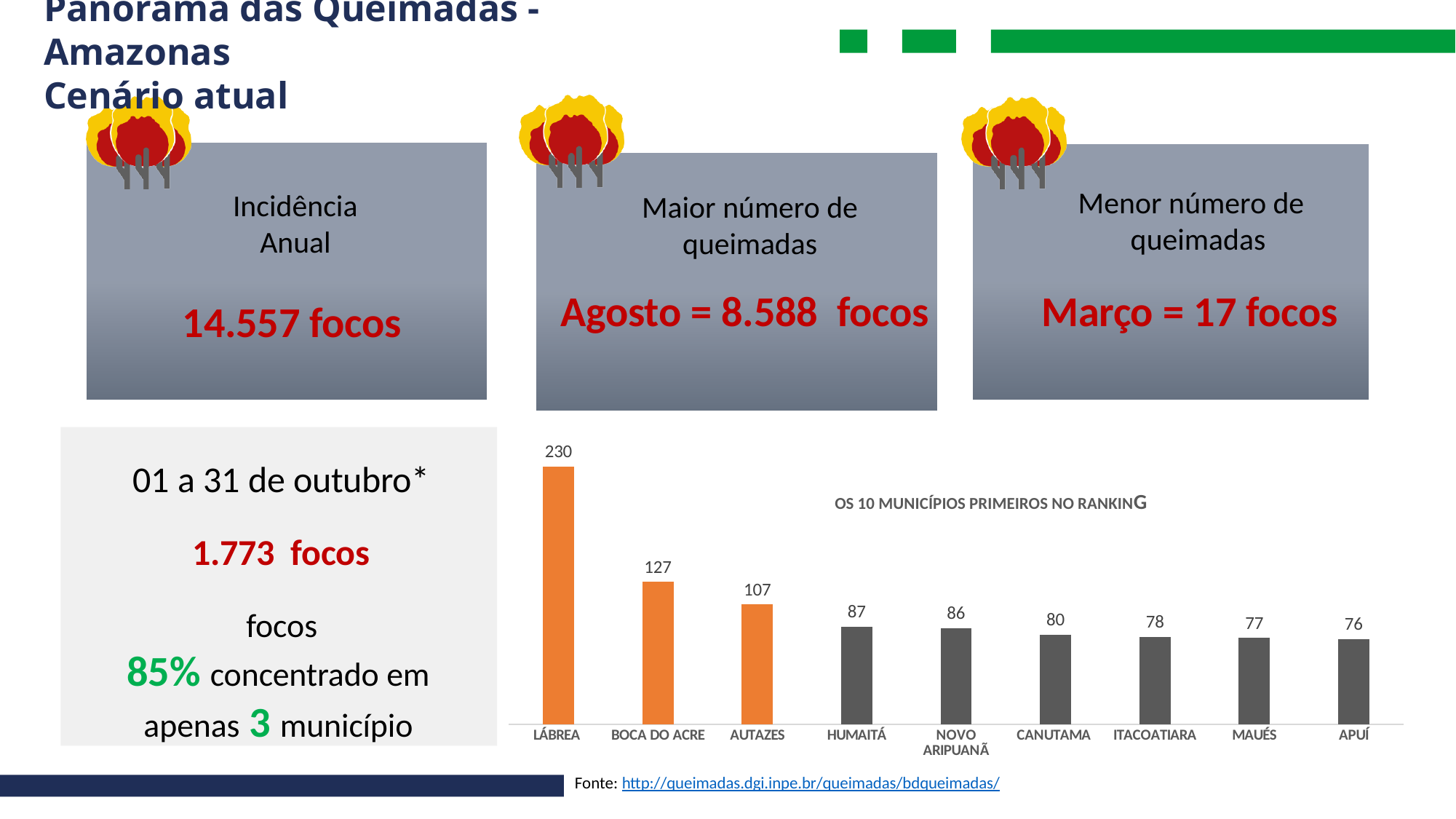
What is the difference between the values for Autazes and Humaitá? 20 Which municipality has the lowest bar in the chart? Apuí What value is shown for Lábrea in the bar chart? 230 What value is shown for Canutama in the bar chart? 80 What value is shown for Boca do Acre in the bar chart? 127 What type of chart is shown on the slide? Bar chart Which municipality has the highest bar in the chart? Lábrea What value is shown for Apuí in the bar chart? 76 What is the title of the bar chart? OS 10 MUNICÍPIOS PRIMEIROS NO RANKING How many municipalities have bars plotted in the chart? 9 Which has a larger value, Boca do Acre or Autazes? Boca do Acre What is the difference between the values for Lábrea and Boca do Acre? 103